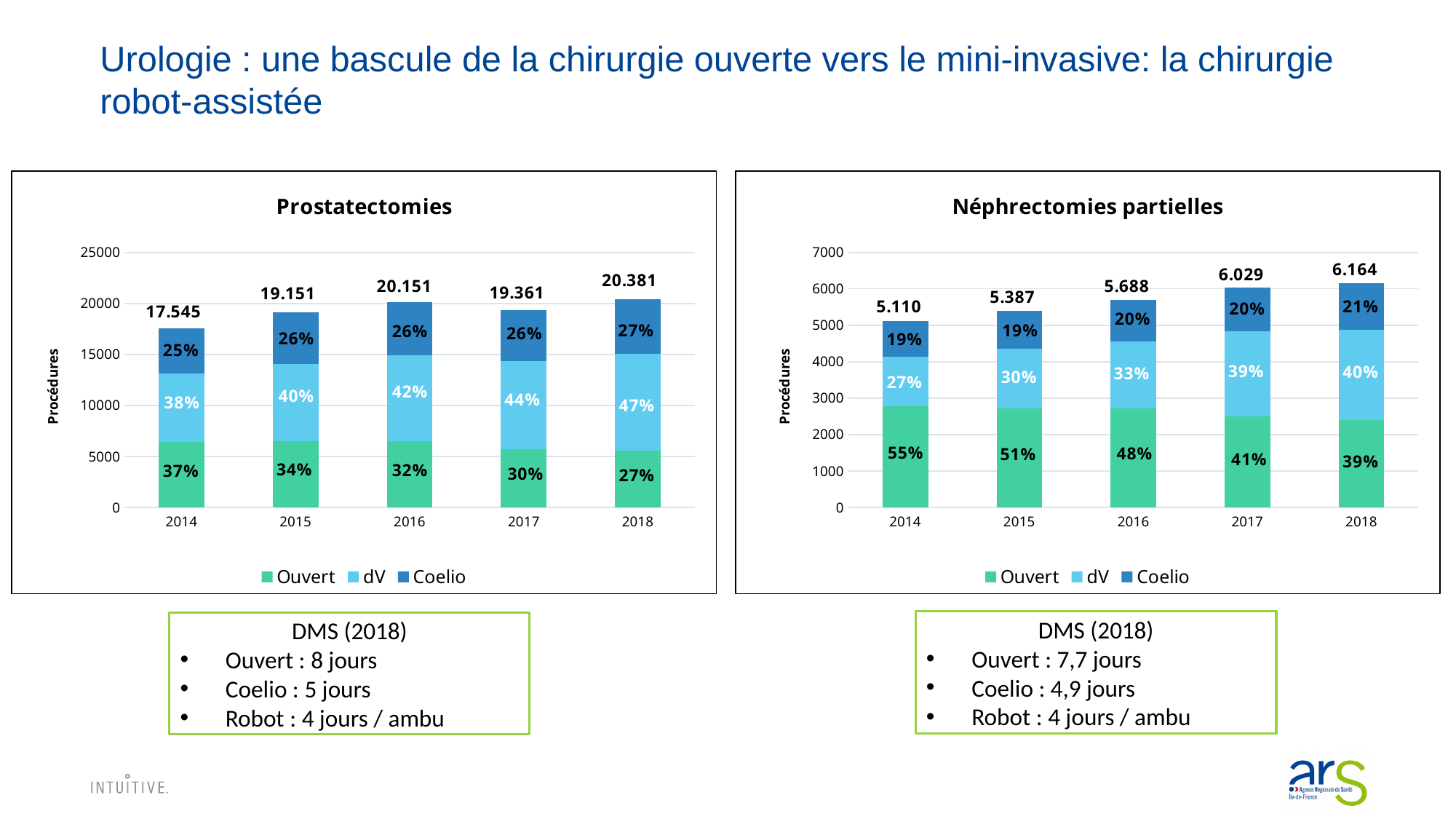
In the Prostatectomies chart, what is the total number of procedures shown above the bar for 2018? 20.381 In the Néphrectomies partielles chart, which year has the highest total number of procedures? 2018 In the Prostatectomies chart, what percentage does the dV segment show for 2016? 42% In the Néphrectomies partielles chart, is the dV percentage for 2018 larger or smaller than the Ouvert percentage for 2018? larger In the Néphrectomies partielles chart, how many years are shown on the x axis? 5 In the Prostatectomies chart, which year has the highest total number of procedures? 2018 In the Prostatectomies chart, how many series does the legend list? 3 In the Prostatectomies chart, which year has the lowest total number of procedures? 2014 In the Néphrectomies partielles chart, what percentage does the Ouvert segment show for 2017? 41% In the Néphrectomies partielles chart, what is the total number of procedures shown above the bar for 2014? 5.110 What kind of chart is the Néphrectomies partielles chart? stacked bar chart In the Prostatectomies chart, does the Ouvert share rise or fall from 2014 to 2018? fall